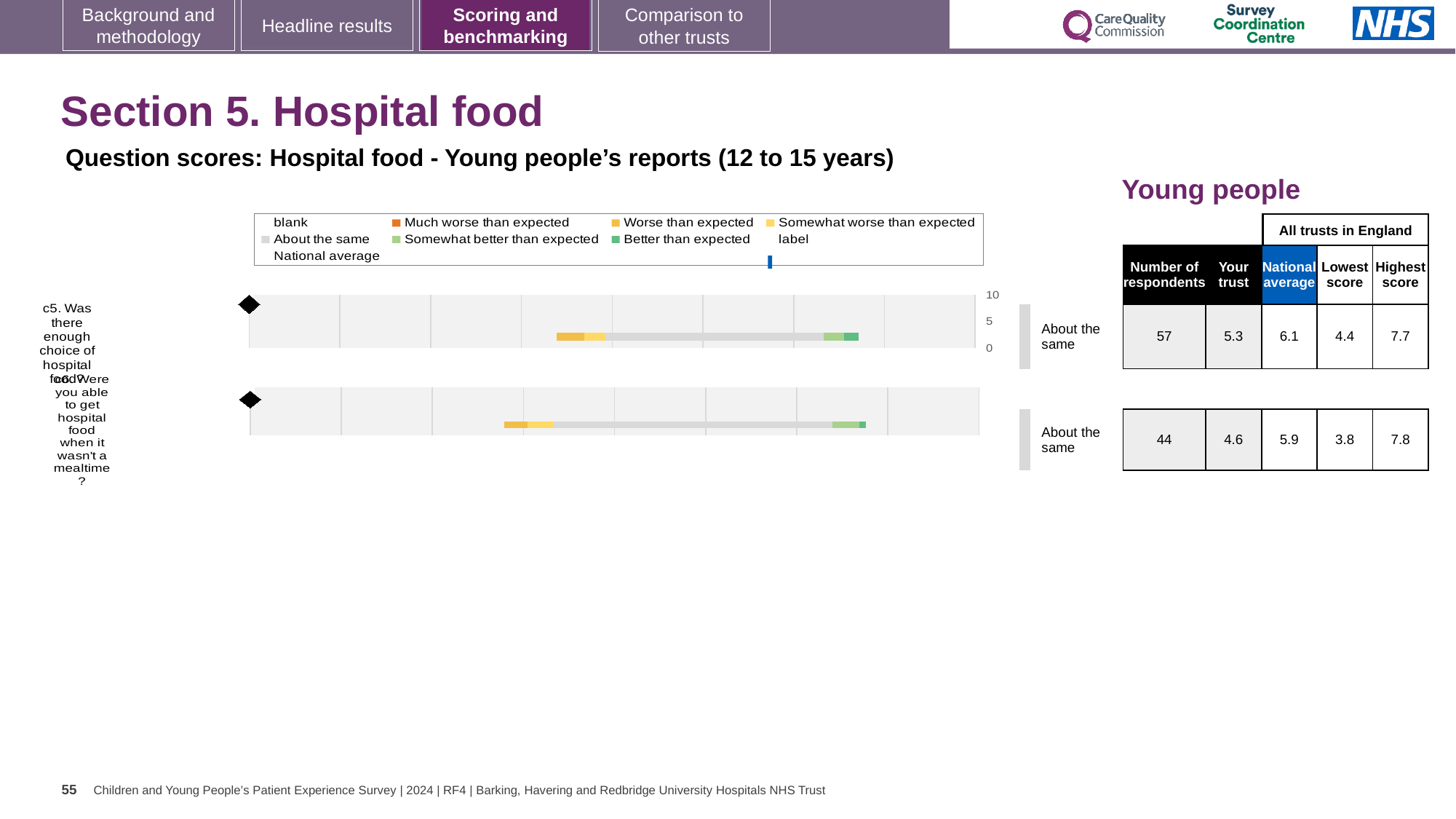
What kind of chart is used to show the question scores for hospital food? Bar chart What benchmark category is shown for question c6? About the same How many respondents answered question c5 (Was there enough choice of hospital food?)? 57 Which colour in the legend represents 'Much worse than expected'? Orange Which question has the higher 'Your trust' score, c5 or c6? c5 What is the 'Your trust' score for question c5 (Was there enough choice of hospital food?)? 5.3 How many more respondents answered question c5 than question c6? 13 What is the difference between the national average and the 'Your trust' score for question c5? 0.8 What is the highest score among all trusts in England for question c6? 7.8 How many questions are plotted in the hospital food chart? 2 What is the national average score for question c6 (Were you able to get hospital food when it wasn't a mealtime?)? 5.9 What is the lowest score among all trusts in England for question c5? 4.4